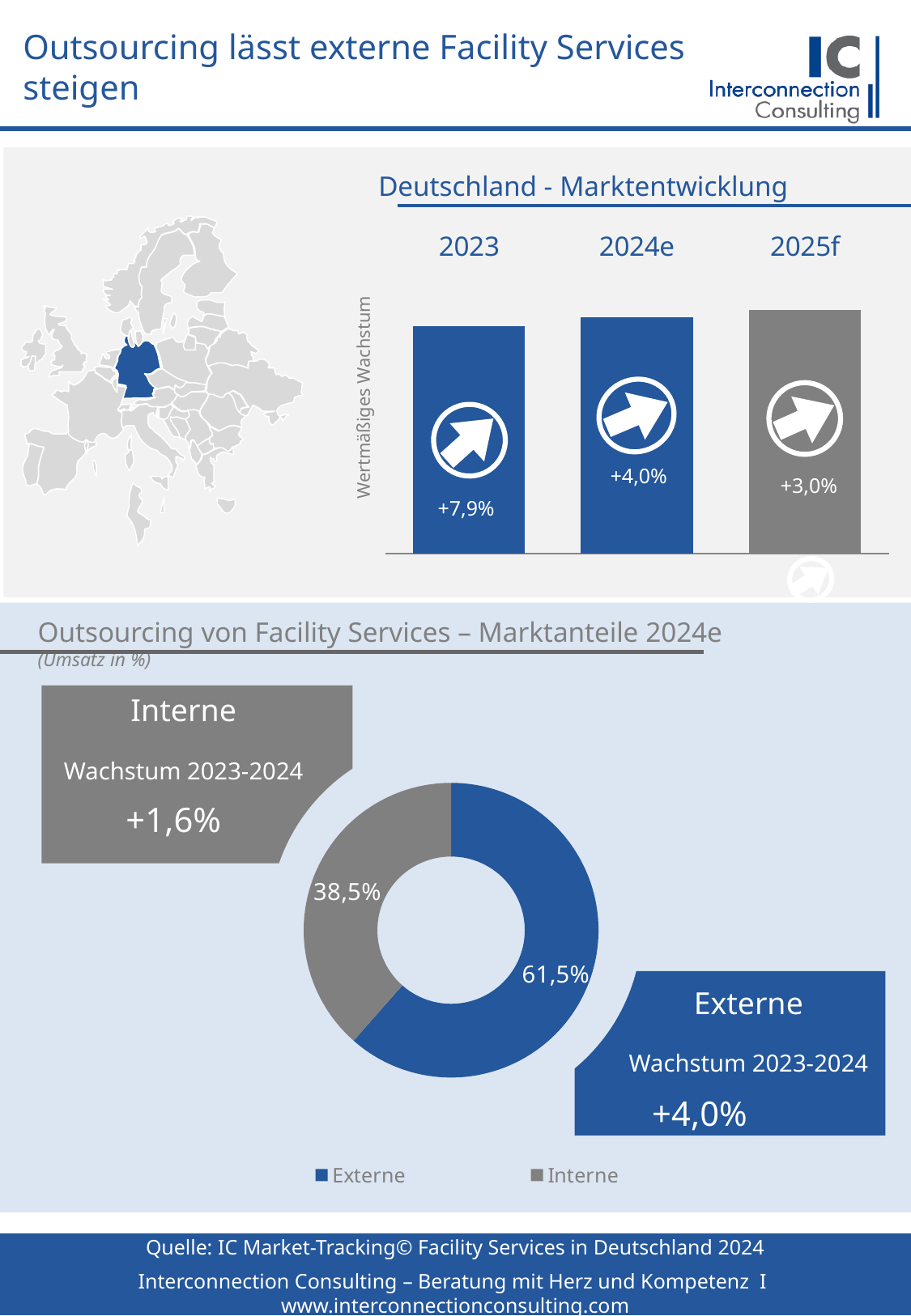
In the 'Deutschland - Marktentwicklung' chart, which year has the lowest growth value according to the data labels? 2025f In the 'Deutschland - Marktentwicklung' chart, which year has the highest growth value according to the data labels? 2023 In the 'Deutschland - Marktentwicklung' chart, how many years are shown? 3 In the 'Deutschland - Marktentwicklung' chart, what is the difference between the 2023 and 2024e growth values? 3,9 percentage points In the 'Deutschland - Marktentwicklung' chart, what is the growth value shown for 2023? +7,9% In the 'Outsourcing von Facility Services – Marktanteile 2024e' chart, what share is shown for Externe? 61,5% In the 'Deutschland - Marktentwicklung' chart, what is the growth value shown for 2025f? +3,0% In the 'Deutschland - Marktentwicklung' chart, what is the growth value shown for 2024e? +4,0% In the 'Outsourcing von Facility Services – Marktanteile 2024e' chart, what share is shown for Interne? 38,5% In the 'Outsourcing von Facility Services – Marktanteile 2024e' chart, which segment is larger, Externe or Interne? Externe What kind of chart is the 'Outsourcing von Facility Services – Marktanteile 2024e' chart? Donut (pie) chart In the 'Deutschland - Marktentwicklung' chart, do the labelled growth values rise or fall from 2023 to 2025f? fall